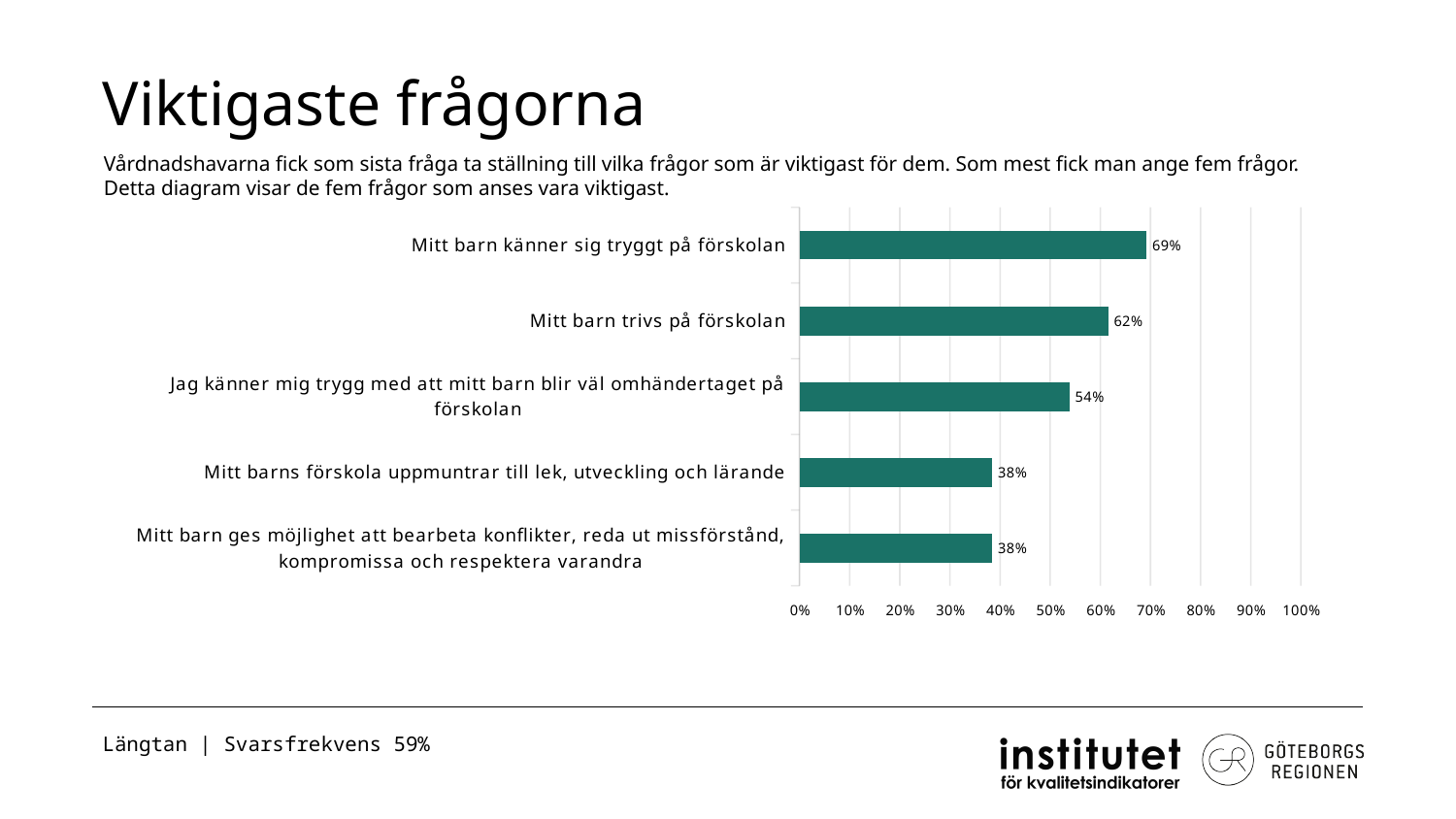
What is the value for "Mitt barn trivs på förskolan"? 62% What is the maximum value shown on the horizontal axis? 100% What is the value for "Mitt barns förskola uppmuntrar till lek, utveckling och lärande"? 38% How many categories are shown in the chart? 5 What is the difference between the values for "Mitt barn trivs på förskolan" and "Jag känner mig trygg med att mitt barn blir väl omhändertaget på förskolan"? 8% What is the difference between the values for "Mitt barn känner sig tryggt på förskolan" and "Mitt barn trivs på förskolan"? 7% What is the value for "Mitt barn känner sig tryggt på förskolan"? 69% Which category has the highest value? Mitt barn känner sig tryggt på förskolan What kind of chart is shown on the slide? bar chart Which is larger: the value for "Mitt barn trivs på förskolan" or the value for "Mitt barns förskola uppmuntrar till lek, utveckling och lärande"? Mitt barn trivs på förskolan Is the value for "Jag känner mig trygg med att mitt barn blir väl omhändertaget på förskolan" greater or less than 50%? greater What is the value for "Jag känner mig trygg med att mitt barn blir väl omhändertaget på förskolan"? 54%